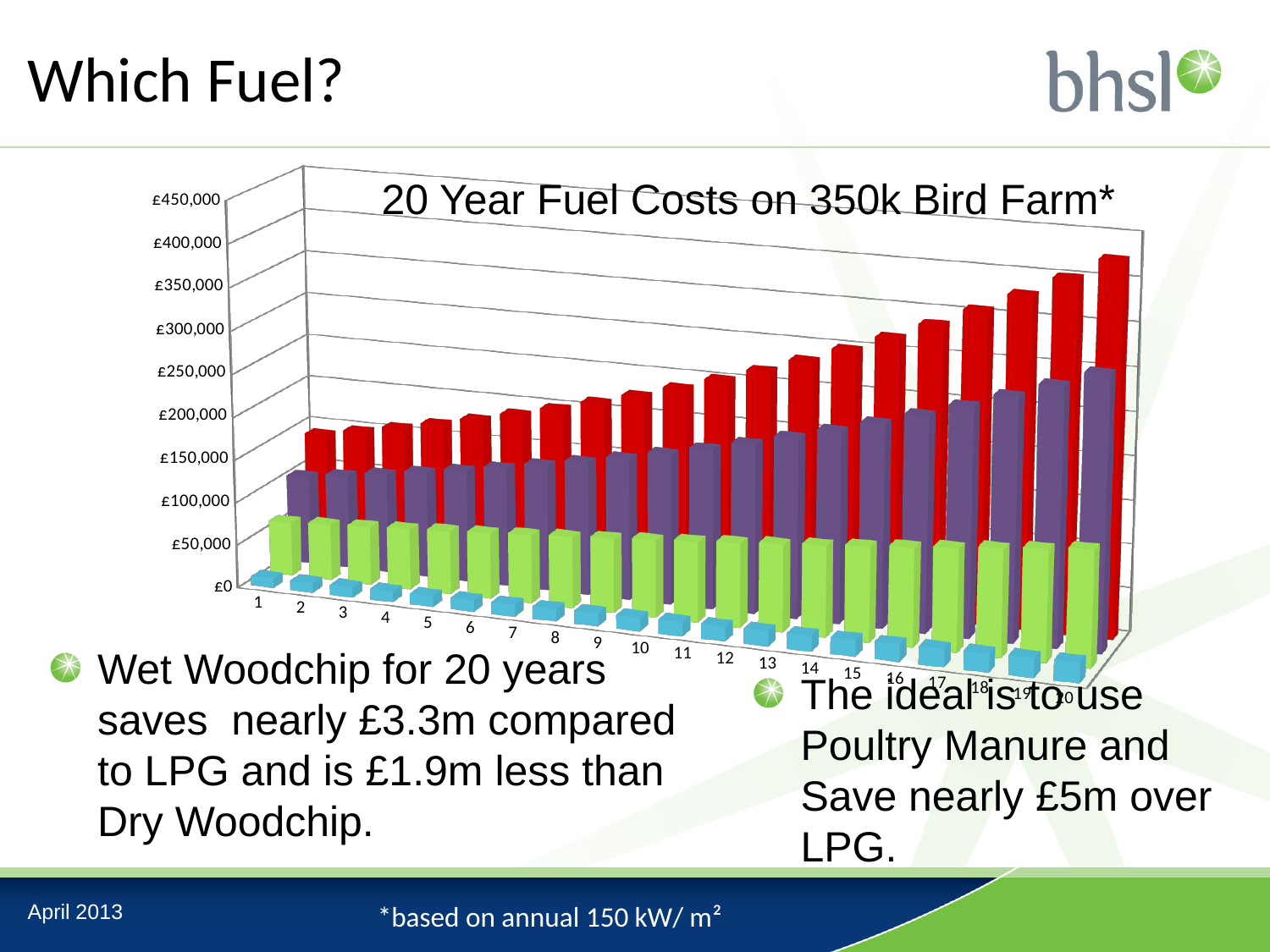
Is the value of the red bar at year 20 greater or less than £250,000? greater What is the title of the chart? 20 Year Fuel Costs on 350k Bird Farm* Is the value of the blue bar at year 1 greater or less than £50,000? less What kind of chart is shown on the slide? bar chart Do the purple bars rise or fall from year 1 to year 20? rise What is the highest value labelled on the vertical axis of the chart? £450,000 How many categories (years) are shown along the x axis of the chart? 20 At year 20, which is larger: the red bar or the purple bar? red Do the red bars rise or fall from year 1 to year 20? rise How many differently coloured series of bars are plotted in the chart? 4 Which coloured series has the shortest bars in the chart? blue Which coloured series has the tallest bars in the chart? red